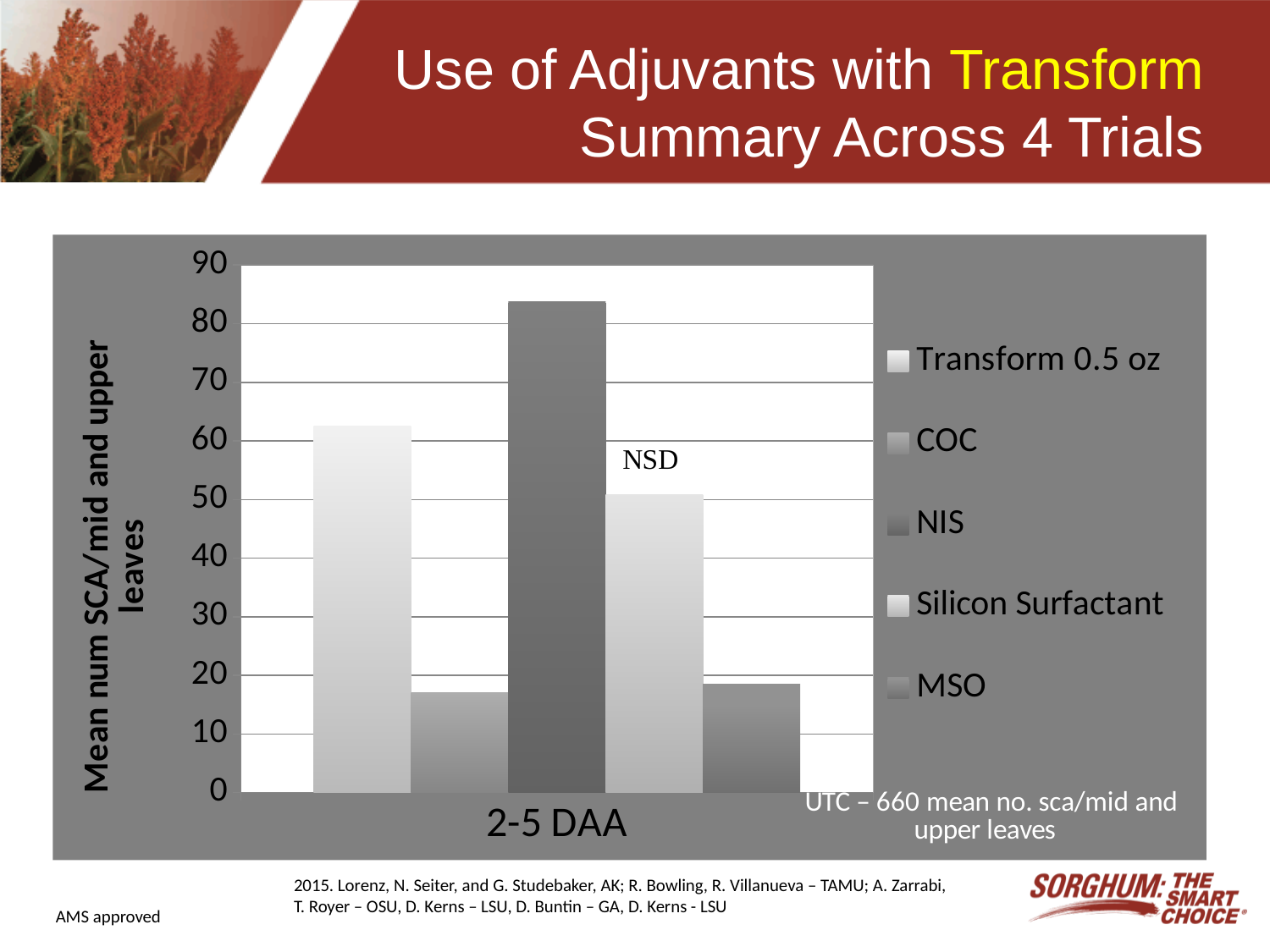
Is the value for Transform 0.5 oz greater or less than 60? greater Is the value for COC greater or less than 20? less What kind of chart is shown on the slide? bar chart Is the value for MSO greater or less than 20? less Which series has the highest bar? NIS What is the label on the x axis of the chart? 2-5 DAA Which is larger, the value for Transform 0.5 oz or the value for Silicon Surfactant? Transform 0.5 oz How many categories are shown on the x axis? 1 How many series does the legend list? 5 What is the title of the y axis? Mean num SCA/mid and upper leaves